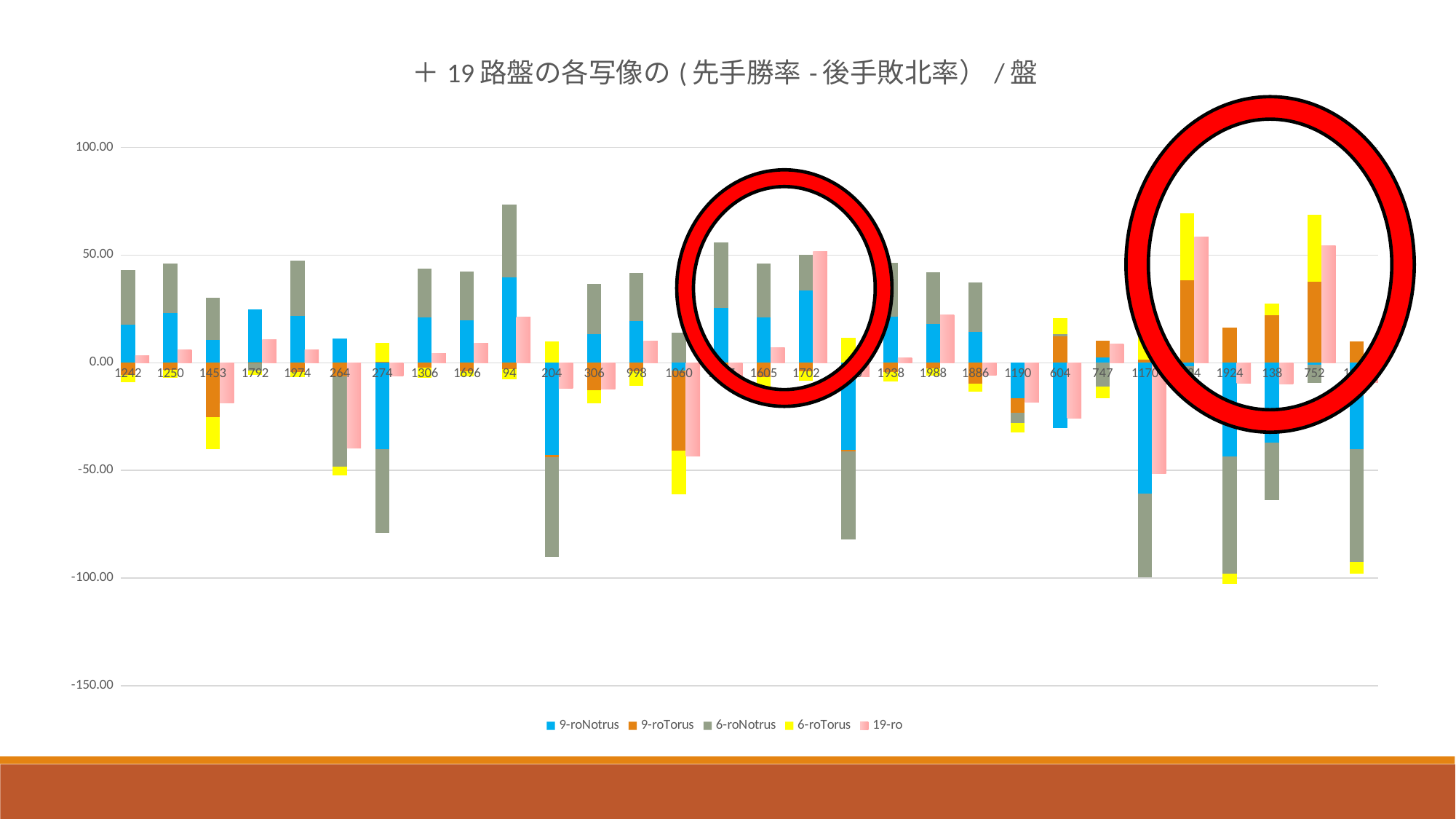
Is the 9-roNotrus value for 1170 greater or less than -50? less Is the 6-roNotrus value for 94 greater or less than 50? less Is the 9-roNotrus value for 1702 greater or less than 0? greater How many series does the legend list? 5 Which colour represents the 19-ro series? pink Which category has the highest 6-roNotrus value? 94 Which is larger, the 9-roNotrus value for 94 or the 9-roNotrus value for 1242? 94 What kind of chart is shown on the slide? bar chart What are the series names listed in the legend? 9-roNotrus, 9-roTorus, 6-roNotrus, 6-roTorus, 19-ro